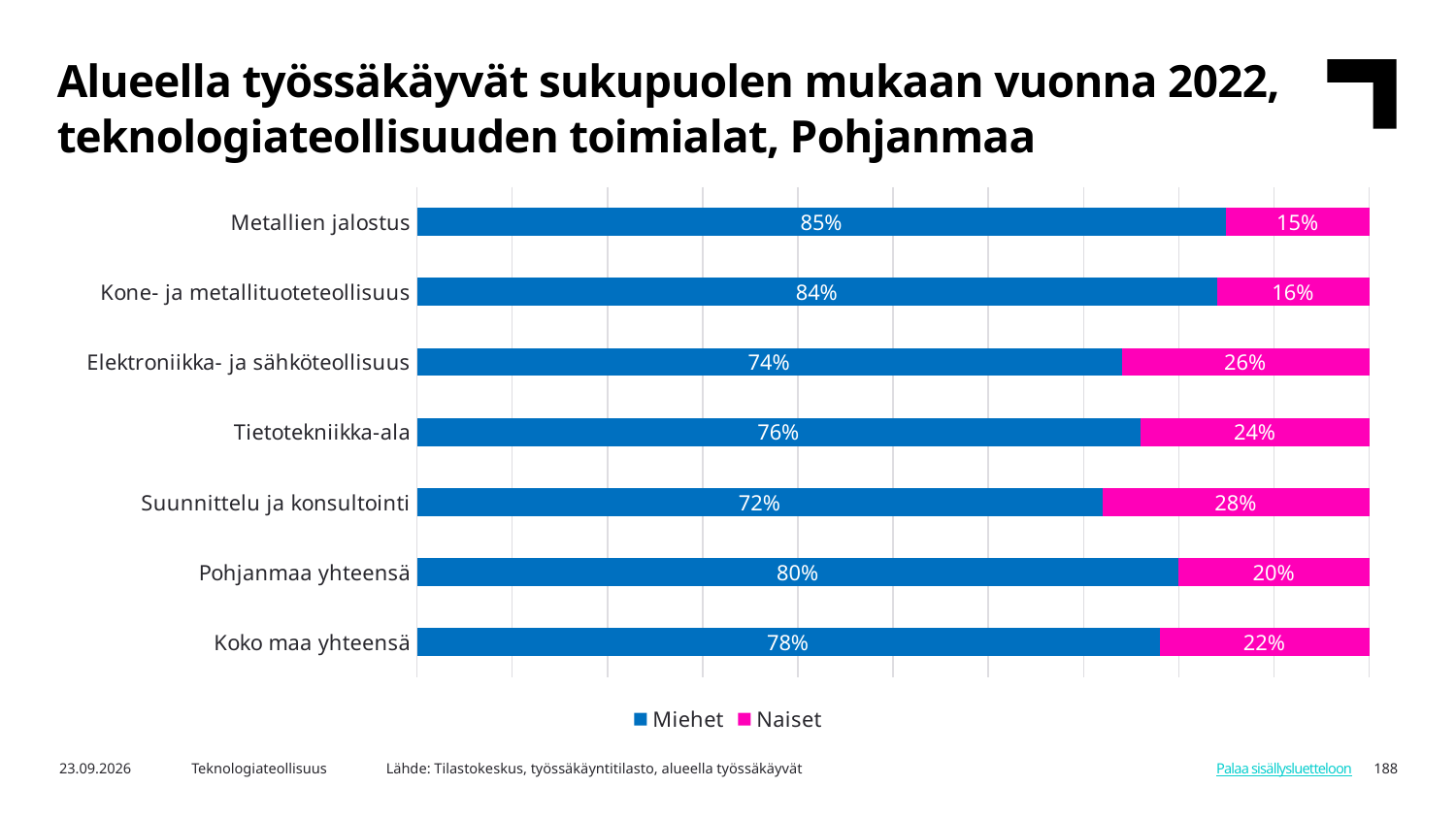
Which category has the highest Naiset share? Suunnittelu ja konsultointi What is the Miehet share for Koko maa yhteensä? 78% Which category has the lowest Naiset share? Metallien jalostus What is the difference between the Miehet share for Metallien jalostus and for Suunnittelu ja konsultointi? 13 percentage points What is the Naiset share for Pohjanmaa yhteensä? 20% What is the total of the stacked bar for Kone- ja metallituoteteollisuus? 100% What is the Miehet share for Metallien jalostus? 85% Which has a larger Naiset share, Tietotekniikka-ala or Elektroniikka- ja sähköteollisuus? Elektroniikka- ja sähköteollisuus What is the Naiset share for Suunnittelu ja konsultointi? 28% How many categories are shown on the chart? 7 What kind of chart is shown on the slide? Stacked bar chart How many series does the legend list? 2